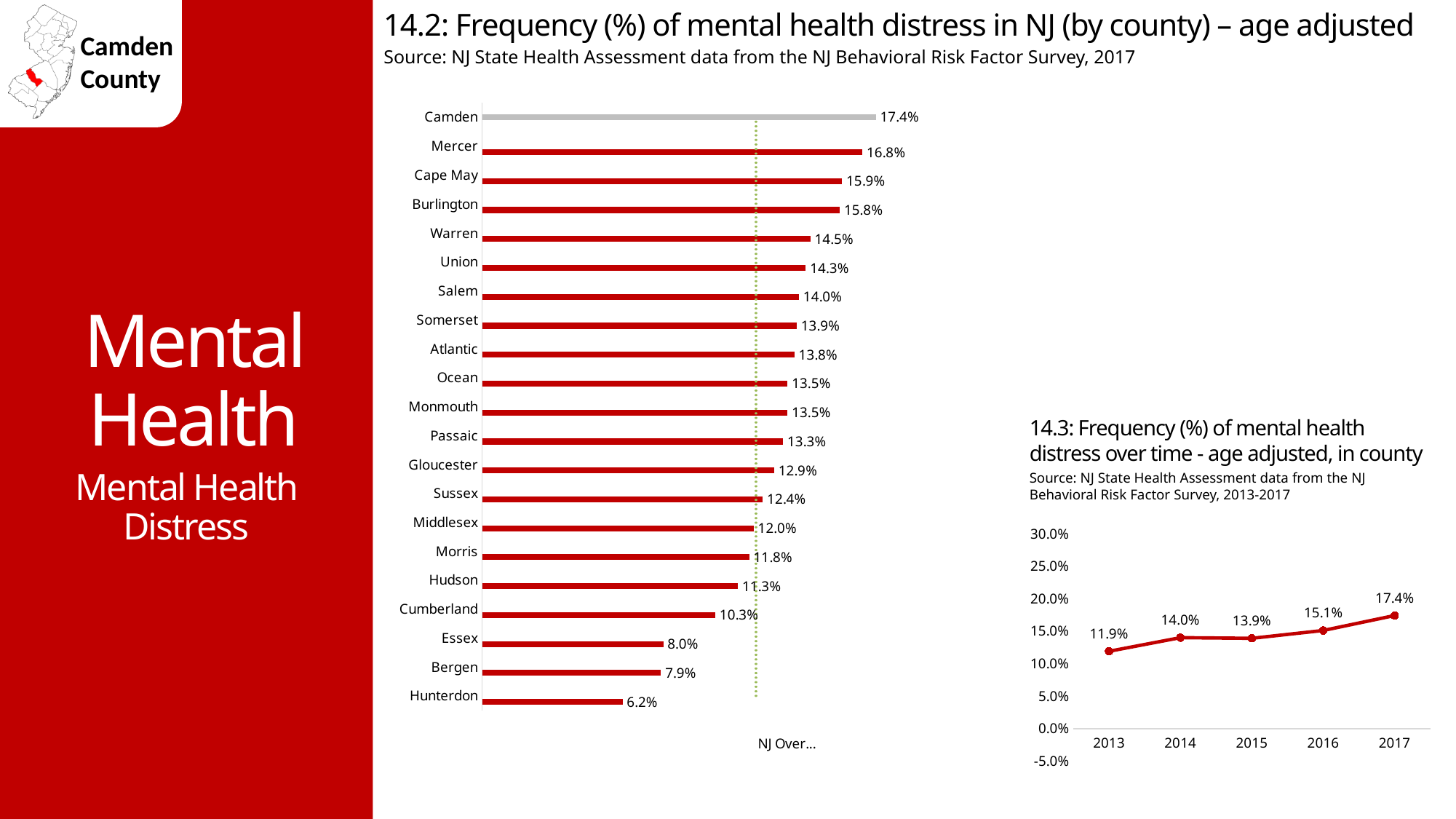
In chart 14.2, what is the frequency of mental health distress for Camden? 17.4% In chart 14.2, what is the difference between the values for Camden and Hunterdon? 11.2% In chart 14.2, how many counties are shown? 21 In chart 14.2, what is the value for Gloucester? 12.9% In chart 14.2, which county has a higher value, Mercer or Cape May? Mercer In chart 14.3, do the values generally rise or fall from 2013 to 2017? Rise What kind of chart is chart 14.2? Bar chart In chart 14.2, which county has the highest frequency of mental health distress? Camden In chart 14.2, which county has the lowest frequency of mental health distress? Hunterdon In chart 14.3, which year has the highest value? 2017 In chart 14.3, what is the value for 2013? 11.9% In chart 14.3, what is the difference between the values for 2017 and 2016? 2.3%